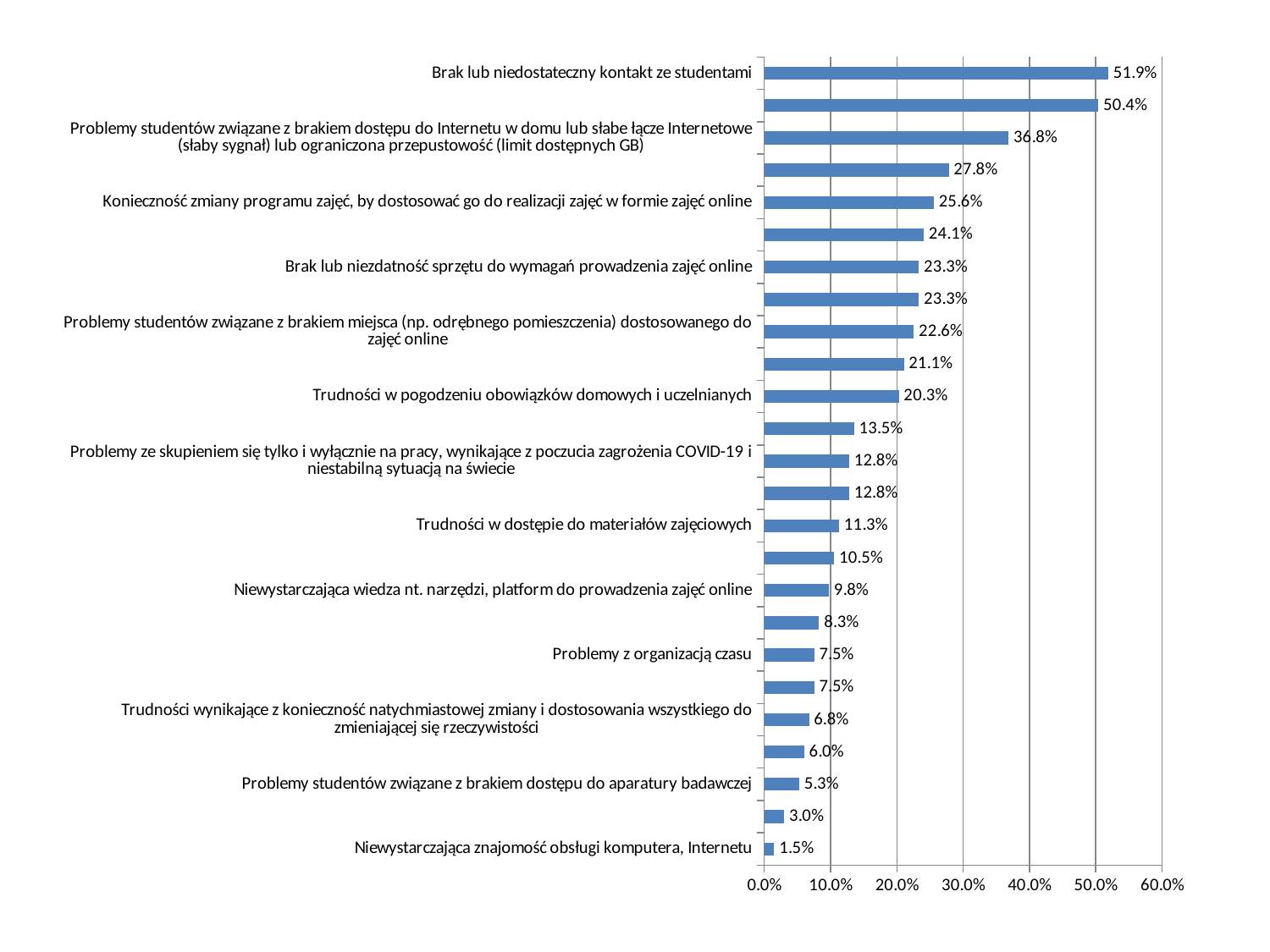
Which is larger: the value for "Problemy z organizacją czasu" or the value for "Niewystarczająca wiedza nt. narzędzi, platform do prowadzenia zajęć online"? Niewystarczająca wiedza nt. narzędzi, platform do prowadzenia zajęć online What is the value for "Brak lub niedostateczny kontakt ze studentami"? 51.9% Which category has the highest value? Brak lub niedostateczny kontakt ze studentami Which category has the lowest value? Niewystarczająca znajomość obsługi komputera, Internetu What is the value for "Trudności w dostępie do materiałów zajęciowych"? 11.3% Is the value for "Brak lub niezdatność sprzętu do wymagań prowadzenia zajęć online" greater or less than 30.0%? less What is the difference between the values for "Brak lub niedostateczny kontakt ze studentami" and "Trudności w pogodzeniu obowiązków domowych i uczelnianych"? 31.6% What is the value for "Konieczność zmiany programu zajęć, by dostosować go do realizacji zajęć w formie zajęć online"? 25.6% What is the value for "Problemy studentów związane z brakiem dostępu do aparatury badawczej"? 5.3% Do the values increase or decrease going from the top bar to the bottom bar? Decrease How many bars are plotted in the chart? 25 What kind of chart is shown on the slide? Bar chart